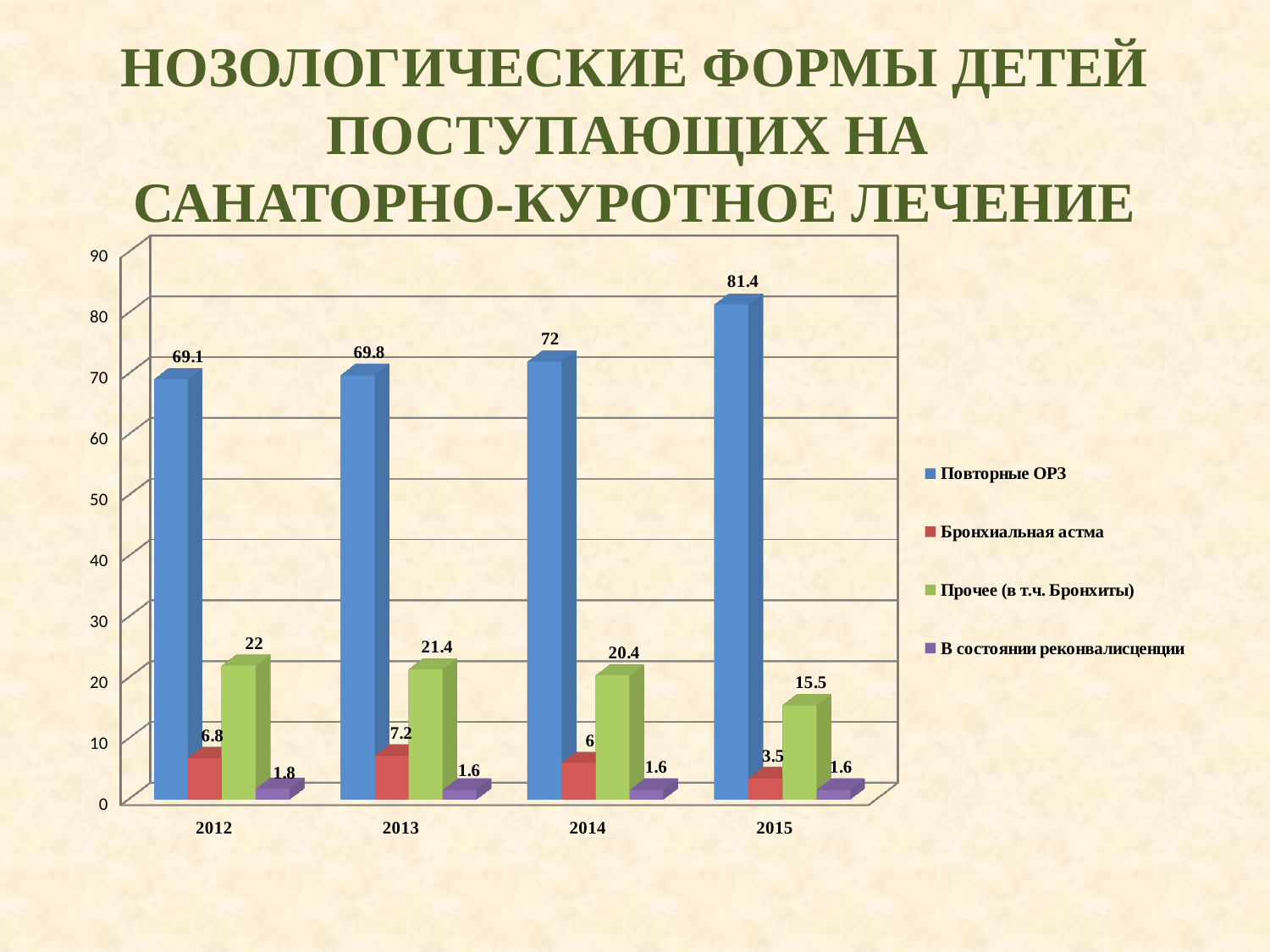
In which year is the value for Прочее (в т.ч. Бронхиты) lowest? 2015 In which year is the value for Повторные ОРЗ highest? 2015 How many series does the legend list? 4 Which is larger, the Бронхиальная астма value in 2012 or in 2015? 2012 What is the value for Бронхиальная астма in 2013? 7.2 Do the values for Прочее (в т.ч. Бронхиты) rise or fall from 2012 to 2015? Fall How many years are shown on the x axis? 4 What is the value for В состоянии реконвалисценции in 2012? 1.8 What kind of chart is shown on the slide? Bar chart What is the value for Повторные ОРЗ in 2015? 81.4 What is the value for Прочее (в т.ч. Бронхиты) in 2014? 20.4 What is the difference between the Повторные ОРЗ values for 2015 and 2012? 12.3